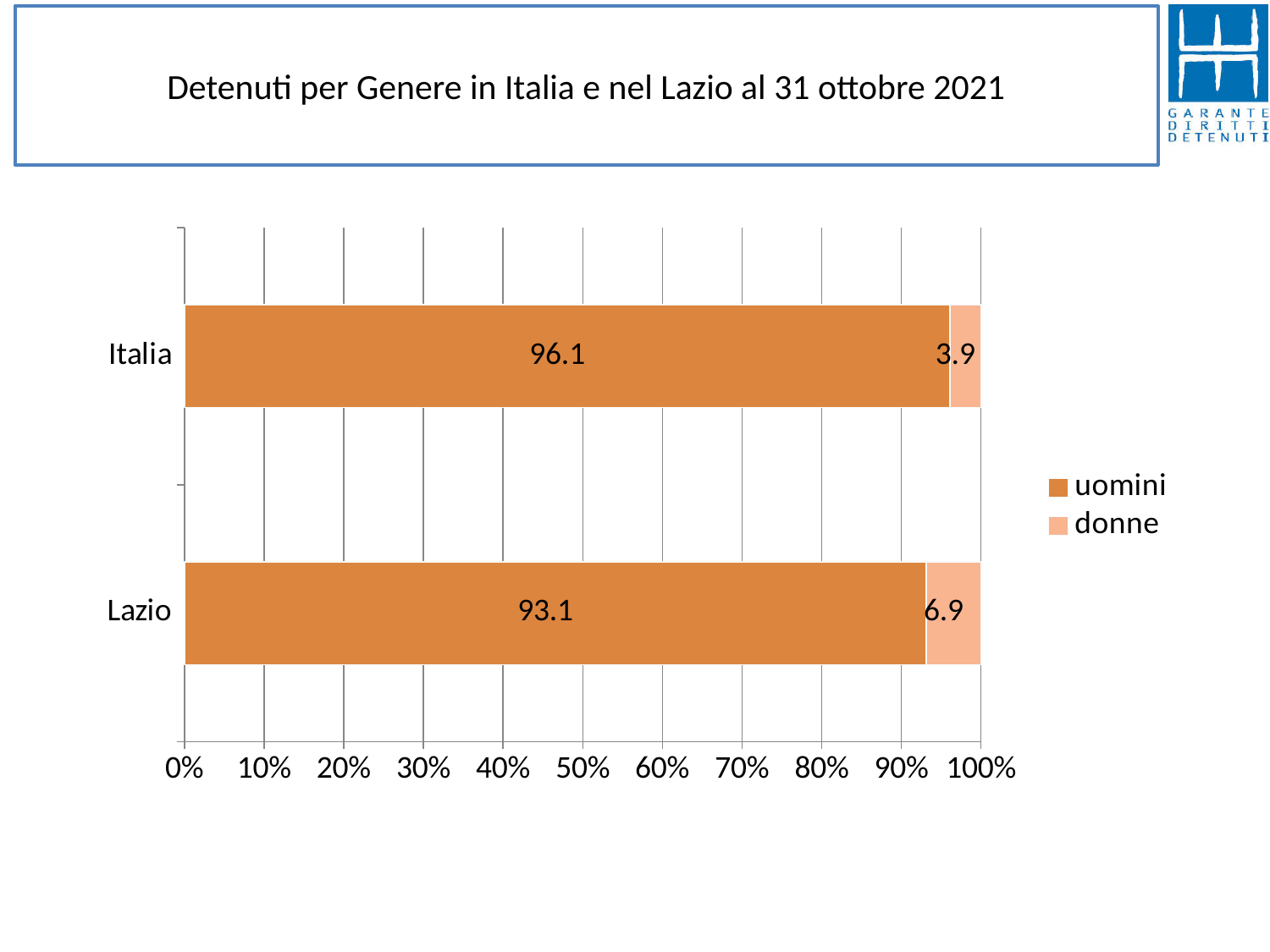
What is the title of the slide? Detenuti per Genere in Italia e nel Lazio al 31 ottobre 2021 Which category has the lower value for uomini? Lazio Which category has the higher value for donne, Italia or Lazio? Lazio What is the value for donne in Lazio? 6.9 What is the value for donne in Italia? 3.9 What is the difference between the donne values for Lazio and Italia? 3 What is the value for uomini in Italia? 96.1 What kind of chart is shown on the slide? Stacked bar chart What is the value for uomini in Lazio? 93.1 What is the difference between the uomini values for Italia and Lazio? 3 How many categories are shown on the chart? 2 How many series does the legend list? 2